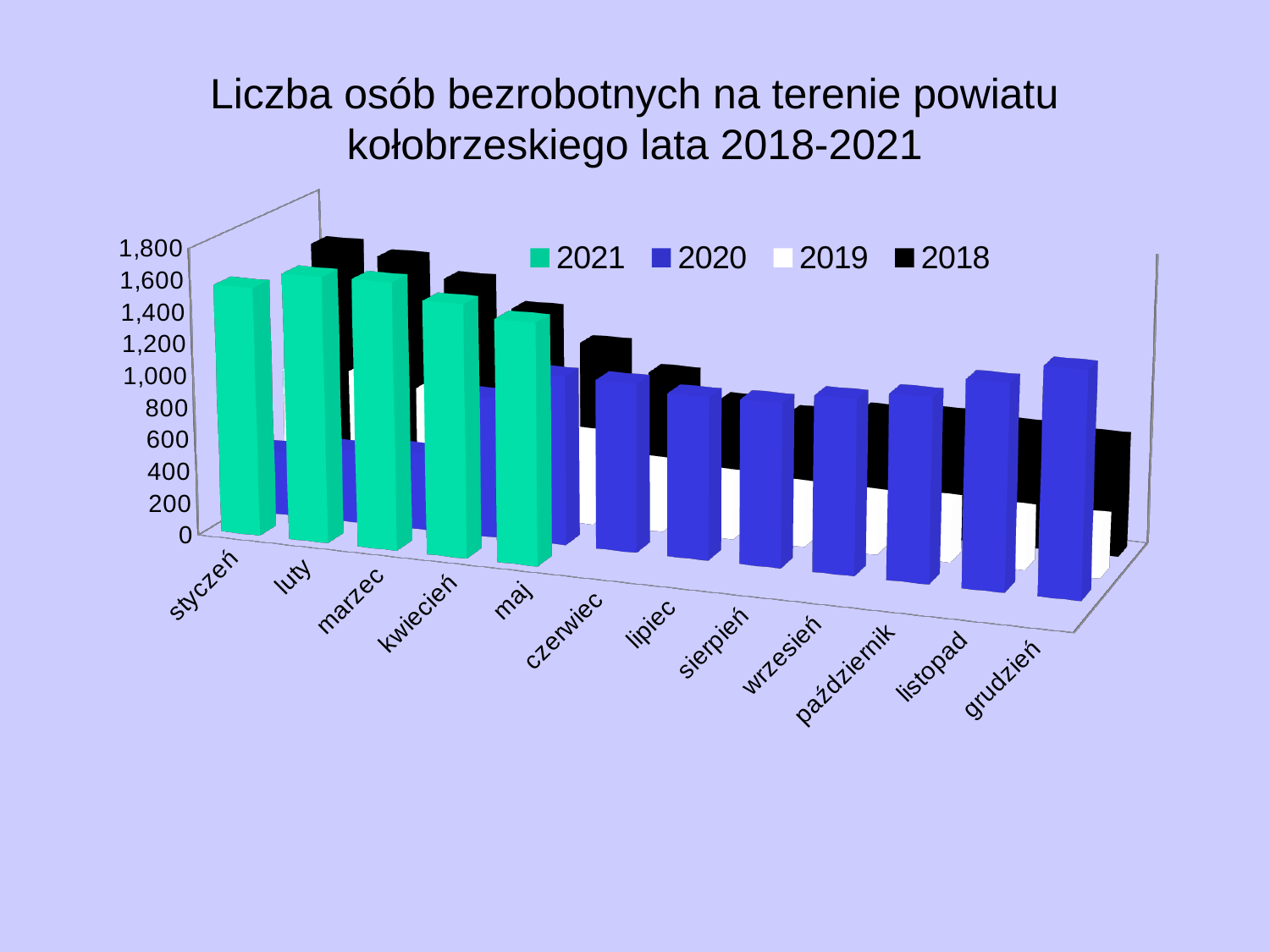
Is the value for styczeń in the 2021 series greater or less than 1,000? greater Which month has the lowest value in the 2021 series? maj Is the value for styczeń in the 2018 series greater or less than 1,000? greater How many months are shown on the x axis? 12 Which series has bars only for styczeń through maj? 2021 For maj, which series has the larger value, 2021 or 2020? 2021 How many series does the legend list? 4 What kind of chart is shown on the slide? bar chart Is the value for lipiec in the 2020 series greater or less than 1,400? less What is the title of the chart? Liczba osób bezrobotnych na terenie powiatu kołobrzeskiego lata 2018-2021